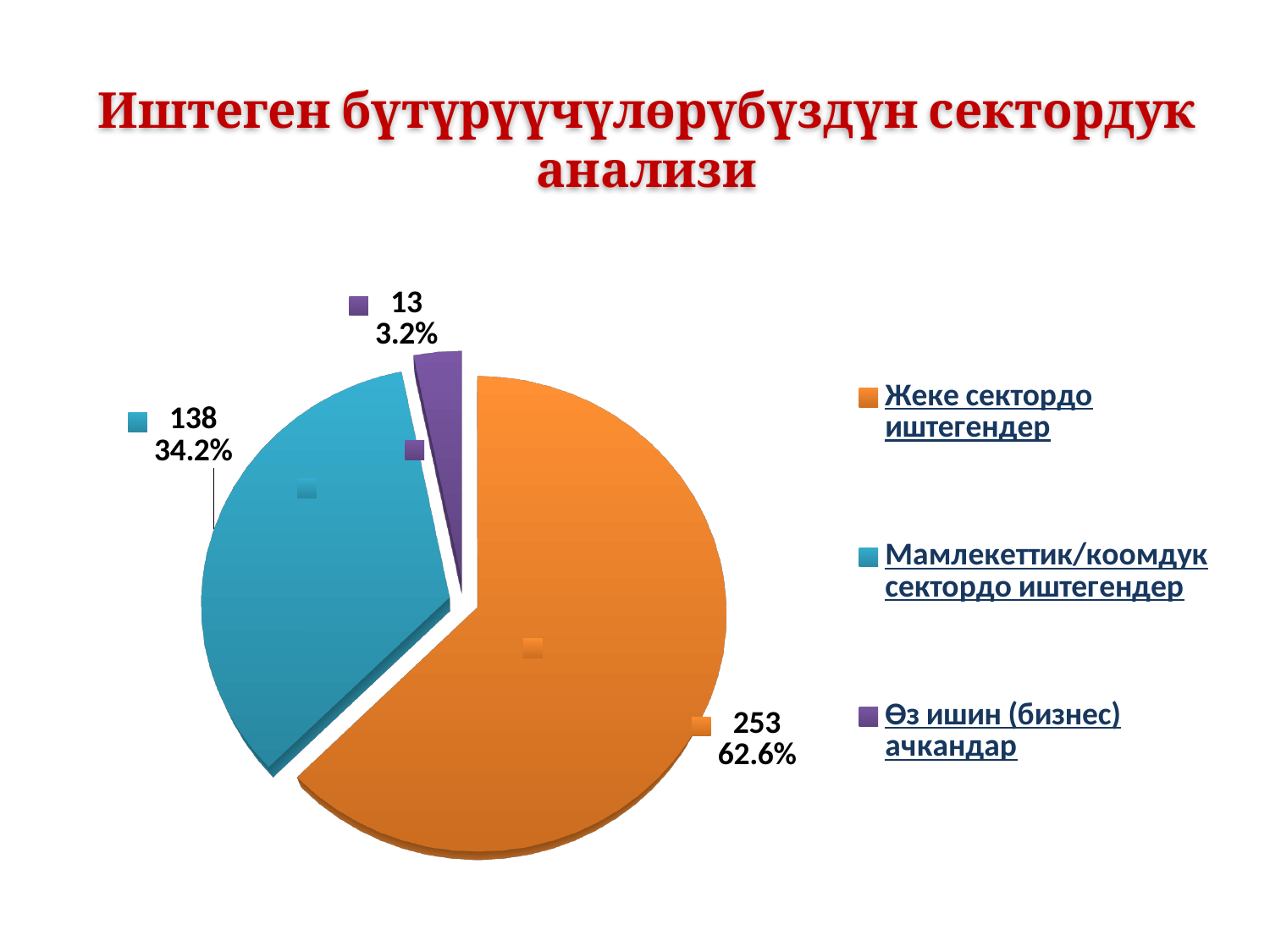
How many slices does the pie chart have? 3 Which category has the smallest slice? Өз ишин (бизнес) ачкандар What share of the pie does Өз ишин (бизнес) ачкандар take? 3.2% What is the value for Өз ишин (бизнес) ачкандар? 13 What is the value for Жеке секторду иштегендер? 253 What is the difference between the values for Жеке секторду иштегендер and Мамлекеттик/коомдук секторду иштегендер? 115 What colour is the slice for Мамлекеттик/коомдук секторду иштегендер? blue How many entries does the legend list? 3 What kind of chart is shown on the slide? pie chart What is the value for Мамлекеттик/коомдук секторду иштегендер? 138 What share of the pie does Жеке секторду иштегендер take? 62.6% Which category has the largest slice? Жеке сектордо иштегендер